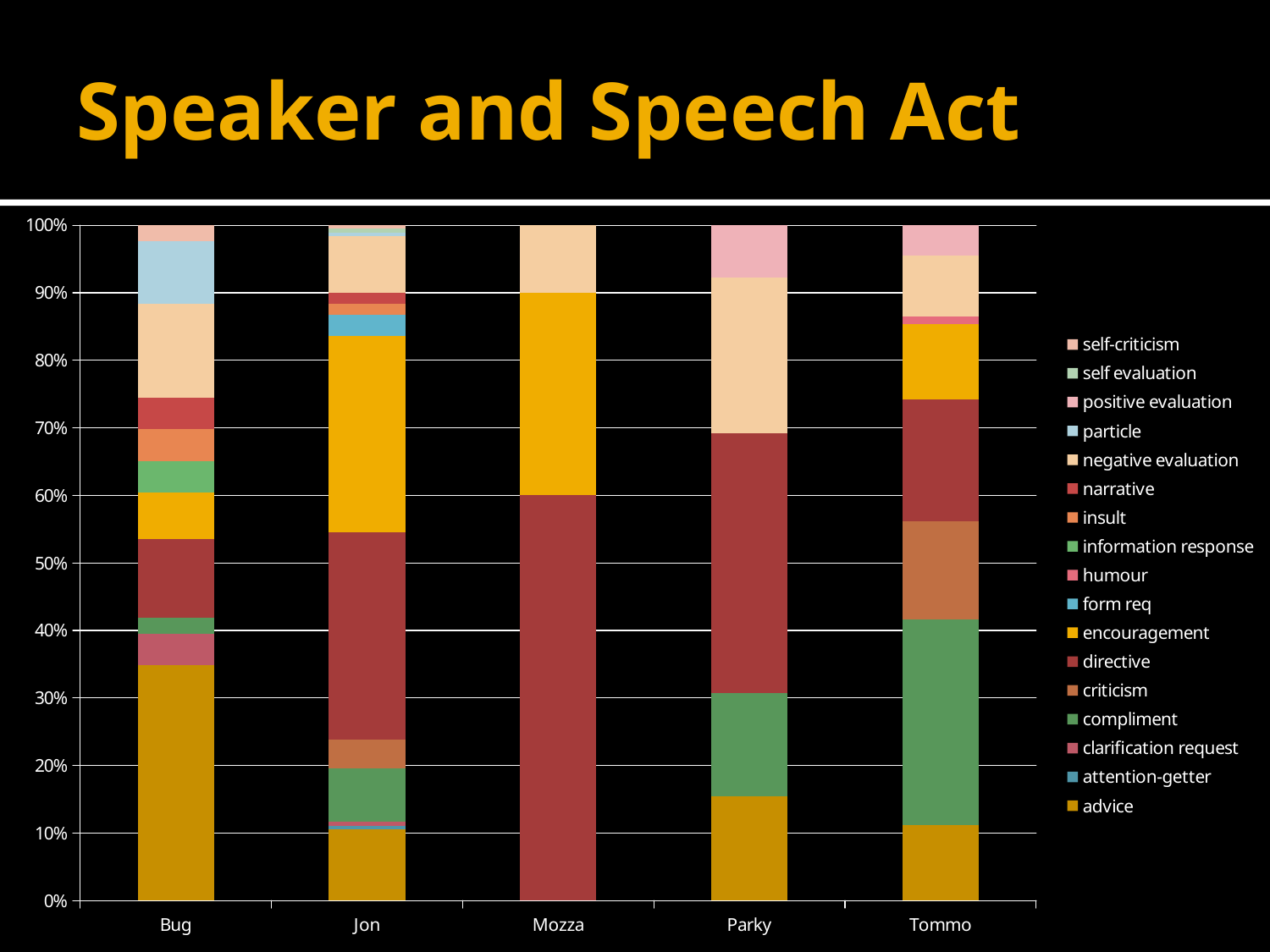
What is the title of the slide? Speaker and Speech Act Which speaker has the largest advice share? Bug How many speakers are shown along the x axis? 5 What kind of chart is shown on the slide? stacked bar chart What does each stacked bar total? 100% How many speech act categories does the legend list? 17 Which legend entry is shown at the bottom of the legend? advice Which speaker has the largest directive share? Mozza Is the advice share for Bug greater or less than 30%? greater Which speaker has the larger compliment share, Jon or Tommo? Tommo Is the advice share for Jon greater or less than 20%? less Is the directive share for Mozza greater or less than 50%? greater